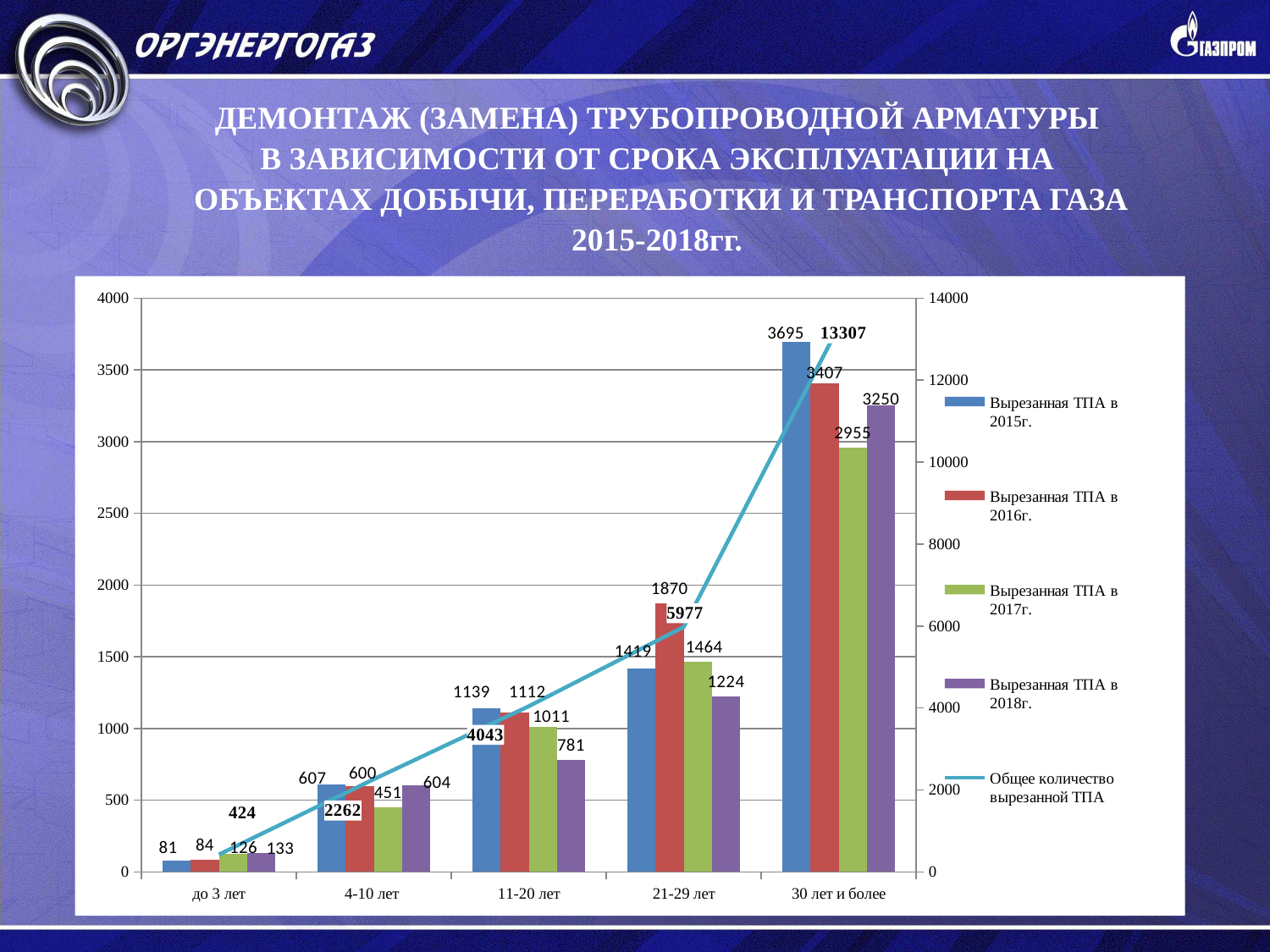
Which category has the highest value for 'Вырезанная ТПА в 2016г.'? 30 лет и более Does the 'Общее количество вырезанной ТПА' line rise or fall from 'до 3 лет' to '30 лет и более'? Rises What colour represents 'Вырезанная ТПА в 2017г.' in the chart? Green What is the value of 'Общее количество вырезанной ТПА' for the '21-29 лет' category? 5977 In the '11-20 лет' category, which is larger: the value for 2017 or the value for 2018? 2017 What is the value for 'Вырезанная ТПА в 2017г.' in the '4-10 лет' category? 451 How many series does the legend list? 5 How many categories are shown on the x axis? 5 What is the value for 'Вырезанная ТПА в 2015г.' in the '30 лет и более' category? 3695 What is the difference between the 2016 and 2015 values in the '21-29 лет' category? 451 Which category has the lowest value for 'Вырезанная ТПА в 2018г.'? до 3 лет What kind of chart is shown on the slide? Combined bar and line chart